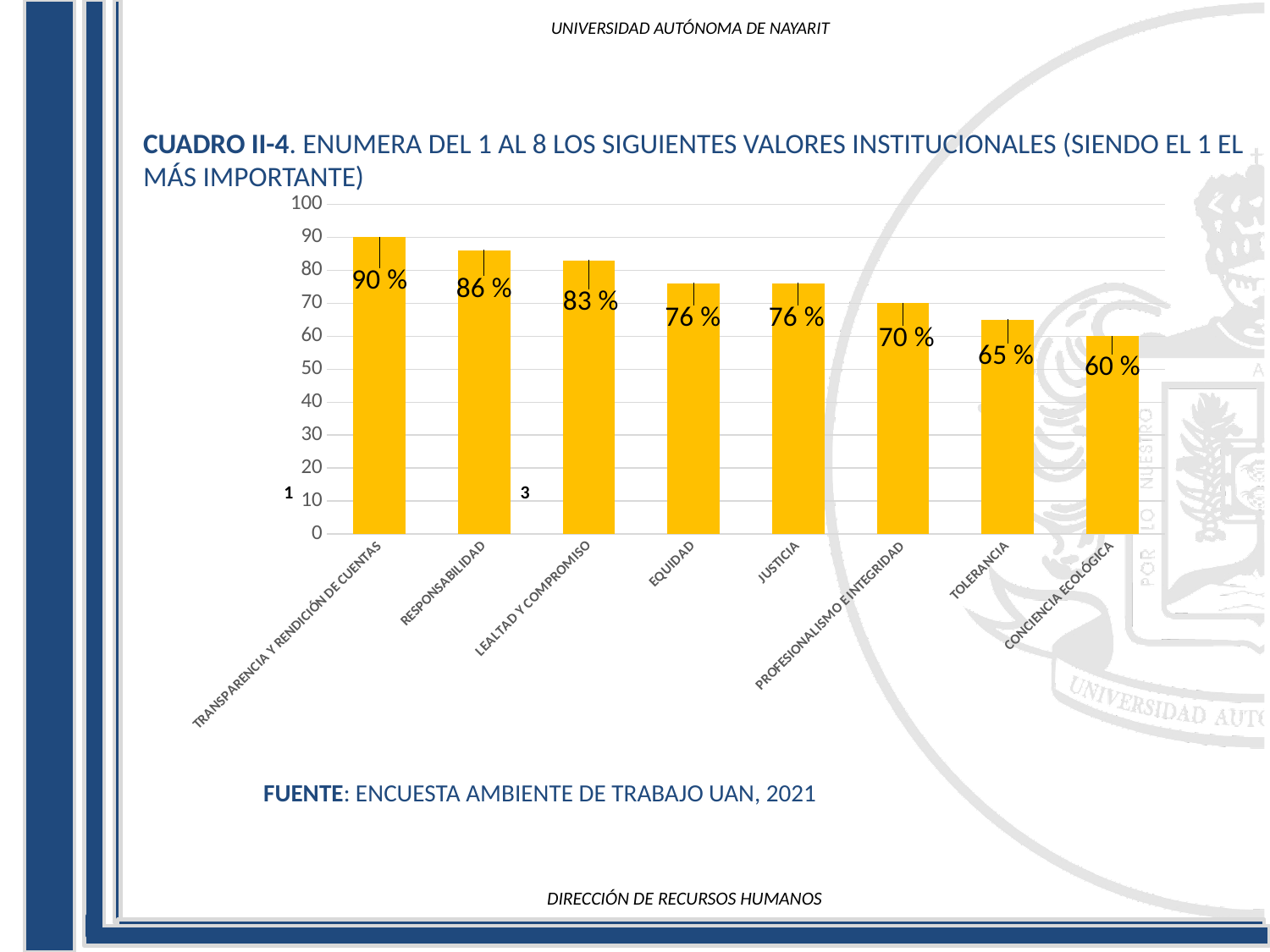
What is the value for LEALTAD Y COMPROMISO? 83 % What kind of chart is shown on the slide? bar chart What is the value for TOLERANCIA? 65 % Do the values rise or fall from left to right along the x axis? fall How many categories are shown on the x axis? 8 Is the value for EQUIDAD greater or less than 70? greater Which category has the highest value? TRANSPARENCIA Y RENDICIÓN DE CUENTAS What is the value for TRANSPARENCIA Y RENDICIÓN DE CUENTAS? 90 % Which is larger, the value for PROFESIONALISMO E INTEGRIDAD or the value for TOLERANCIA? PROFESIONALISMO E INTEGRIDAD What is the value for RESPONSABILIDAD? 86 % What is the difference between the values for TRANSPARENCIA Y RENDICIÓN DE CUENTAS and CONCIENCIA ECOLÓGICA? 30 % Which category has the lowest value? CONCIENCIA ECOLÓGICA